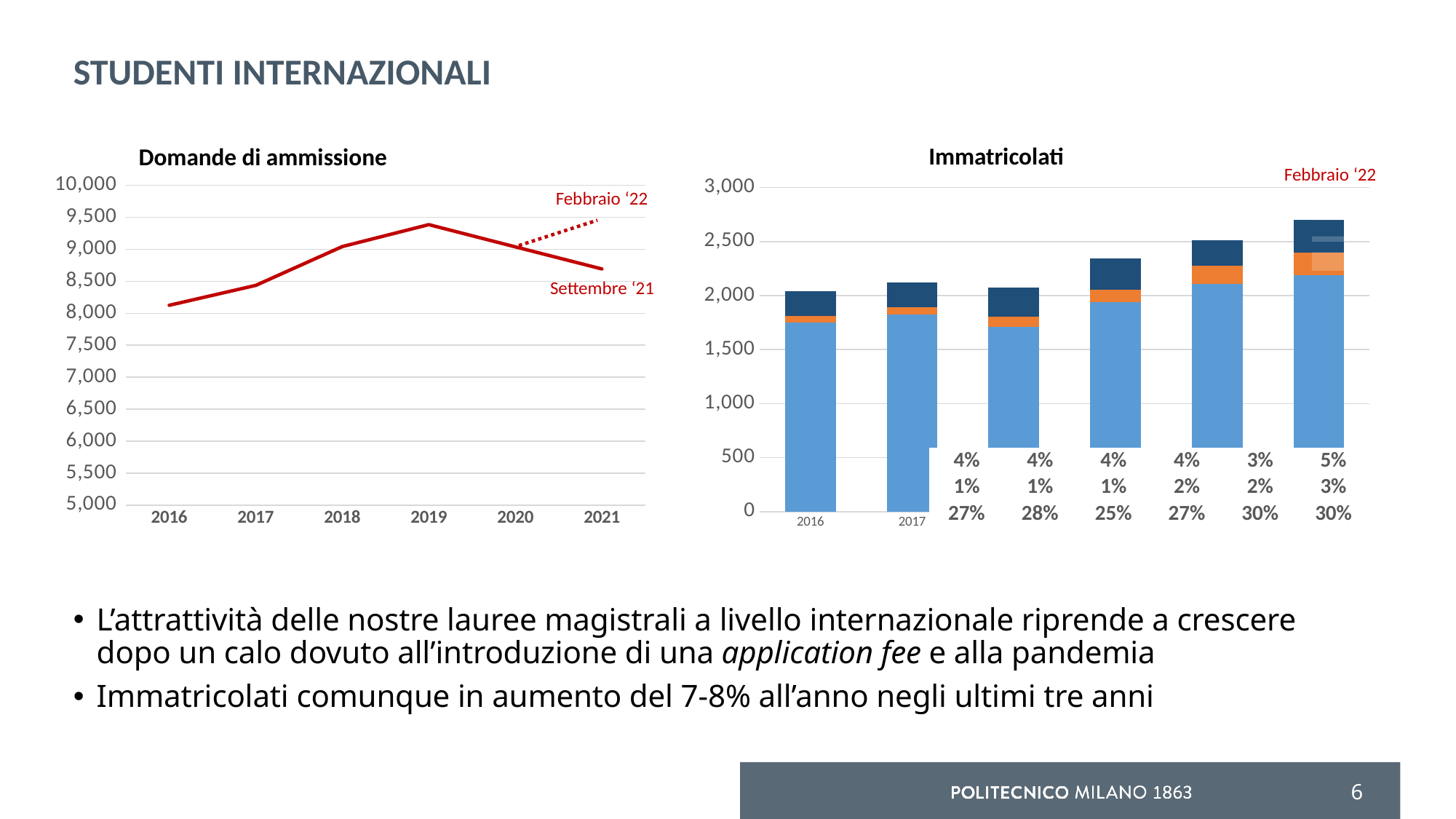
In the 'Domande di ammissione' chart, is the value for 2019 greater or less than 9,000? greater In the 'Domande di ammissione' chart, is the value for 2016 greater or less than 8,500? less In the 'Domande di ammissione' chart, which year has the highest value on the solid line? 2019 In the 'Immatricolati' chart, which bar is taller in total, 2016 or 2017? 2017 What kind of chart is the 'Domande di ammissione' chart? line chart In the 'Domande di ammissione' chart, what label is attached to the dotted line segment? Febbraio '22 In the 'Domande di ammissione' chart, which year has the lowest value? 2016 In the 'Immatricolati' chart, is the total of the 2016 bar greater or less than 2,500? less In the 'Domande di ammissione' chart, does the solid line rise or fall from 2019 to 2021? fall How many stacked bars are shown in the 'Immatricolati' chart? 6 What kind of chart is the 'Immatricolati' chart? bar chart How many years are shown on the x axis of the 'Domande di ammissione' chart? 6